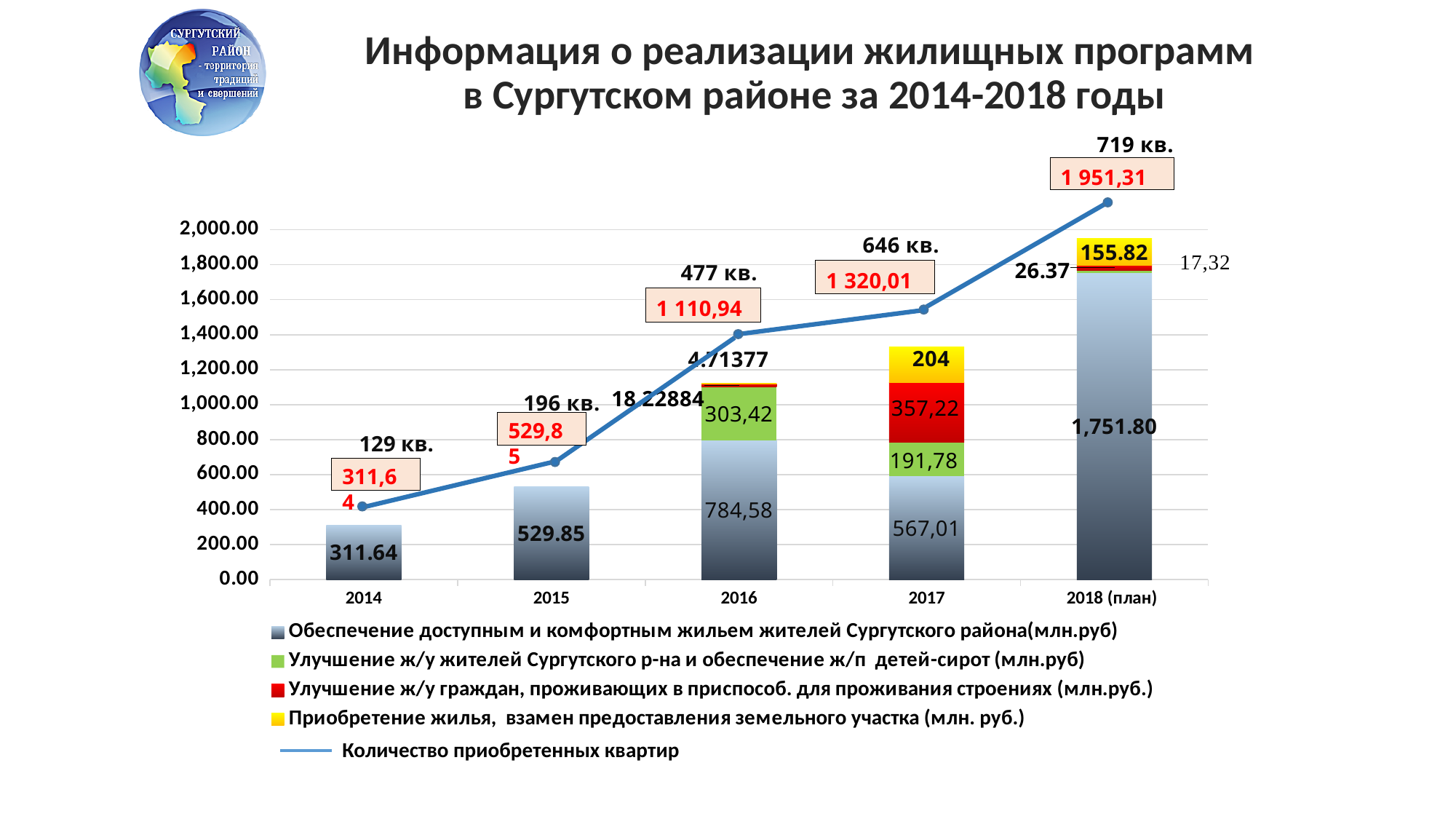
How many apartments (Количество приобретенных квартир) are shown for 2018 (план)? 719 кв. How many categories (years) are shown on the x axis? 5 What is the value of the green series 'Улучшение ж/у жителей Сургутского р-на и обеспечение ж/п детей-сирот (млн.руб)' for 2016? 303,42 Does the line 'Количество приобретенных квартир' rise or fall from 2014 to 2018 (план)? Rises Which is larger: the value of the grey series 'Обеспечение доступным и комфортным жильем...' for 2016 or for 2017? 2016 What is the value of the yellow series 'Приобретение жилья, взамен предоставления земельного участка (млн. руб.)' for 2017? 204 In which year is the value of the series 'Обеспечение доступным и комфортным жильем жителей Сургутского района(млн.руб)' the highest? 2018 (план) What kind of chart is shown on the slide? Stacked bar chart with a line What is the difference between the red series value (357,22) and the green series value (191,78) for 2017? 165,44 What is the value of the red series 'Улучшение ж/у граждан, проживающих в приспособ. для проживания строениях (млн.руб.)' for 2017? 357,22 How many series does the legend list? 5 What is the value of the series 'Обеспечение доступным и комфортным жильем жителей Сургутского района(млн.руб)' for 2014? 311.64